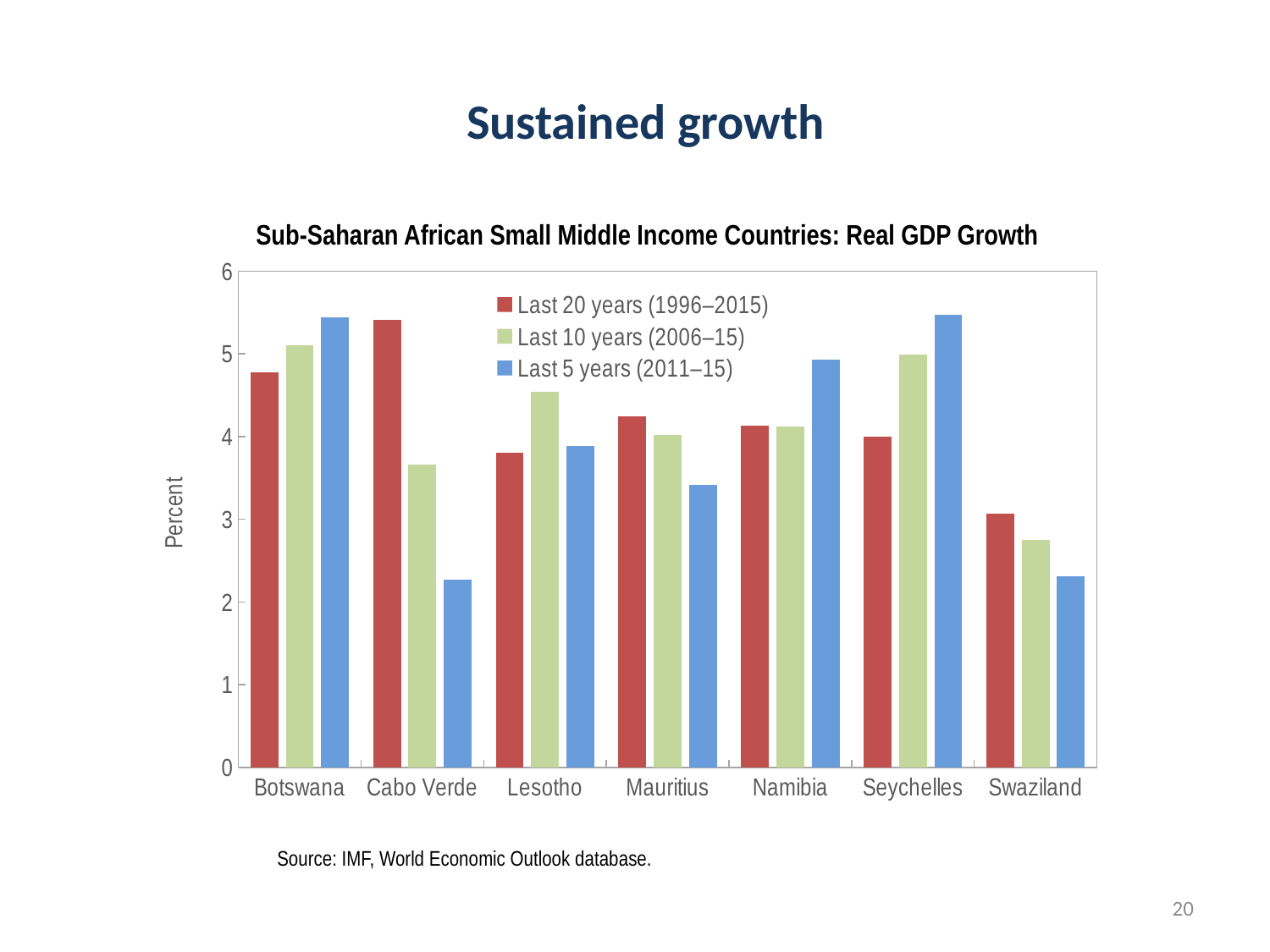
For Cabo Verde, which is larger: the value for Last 20 years (1996–2015) or Last 5 years (2011–15)? Last 20 years (1996–2015) What is the label on the chart's vertical axis? Percent Is the value for Botswana in Last 5 years (2011–15) greater or less than 5? greater How many series does the chart's legend list? 3 Which country has the lowest value for Last 10 years (2006–15)? Swaziland How many countries are shown on the x axis of the chart? 7 Is the value for Mauritius in Last 5 years (2011–15) greater or less than 4? less What kind of chart is shown on the slide? Bar chart Is the value for Cabo Verde in Last 5 years (2011–15) greater or less than 3? less Which country has the highest value for Last 20 years (1996–2015)? Cabo Verde For Seychelles, which is larger: the value for Last 20 years (1996–2015) or Last 5 years (2011–15)? Last 5 years (2011–15) Which country has the lowest value for Last 20 years (1996–2015)? Swaziland